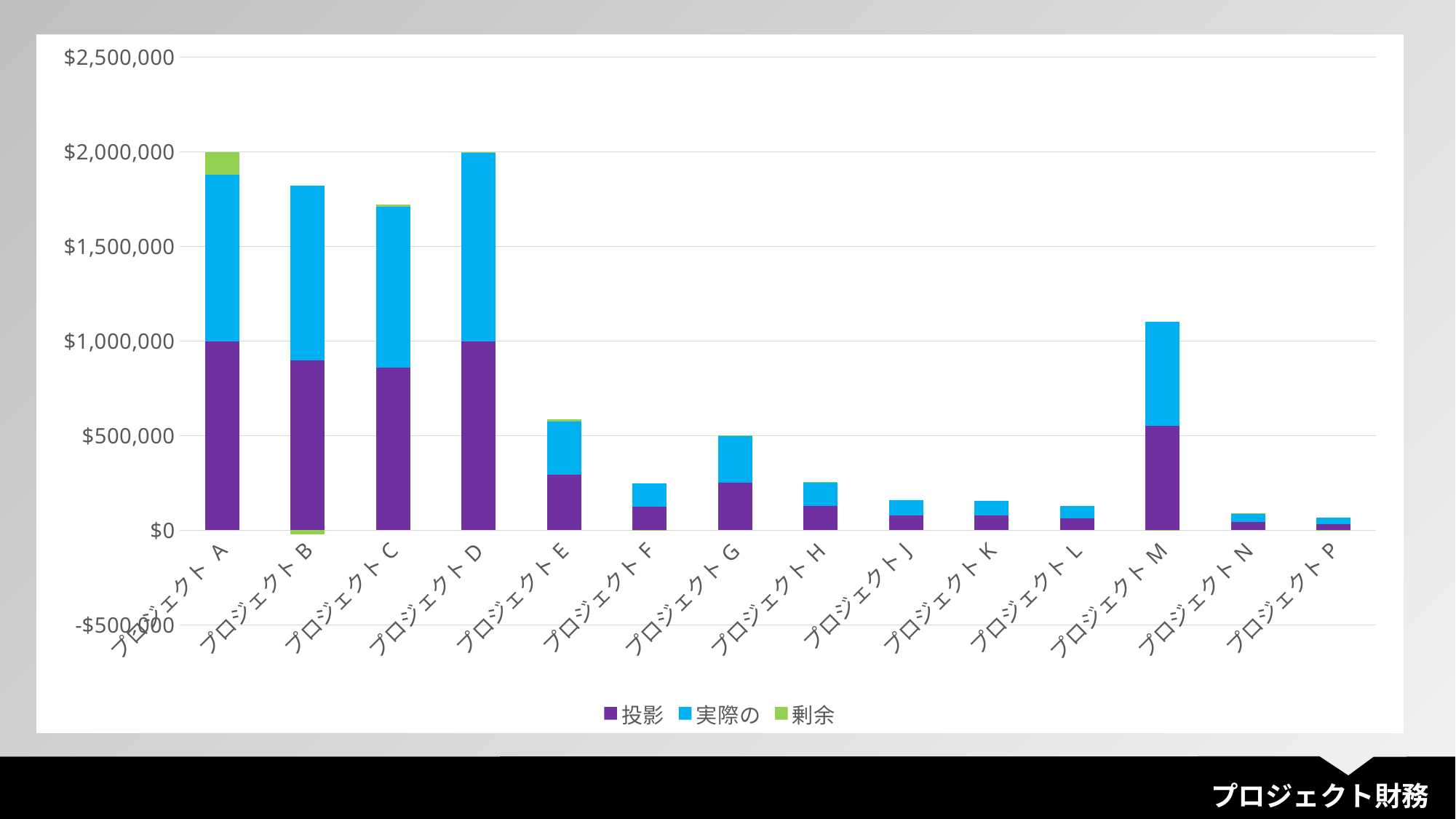
Is the total bar for プロジェクト M greater or less than $1,000,000? greater Which has the larger total bar, プロジェクト B or プロジェクト M? プロジェクト B How many projects are shown on the x axis? 14 Which colour represents the 剰余 series in the legend? Green How many series does the legend list? 3 Is the total bar for プロジェクト E greater or less than $1,000,000? less Is the 投影 value for プロジェクト C greater or less than $1,000,000? less What is the title shown on the slide? プロジェクト財務 What kind of chart is shown on the slide? Stacked bar chart Which has the larger 投影 value, プロジェクト A or プロジェクト C? プロジェクト A Which project has the lowest total bar? プロジェクト P